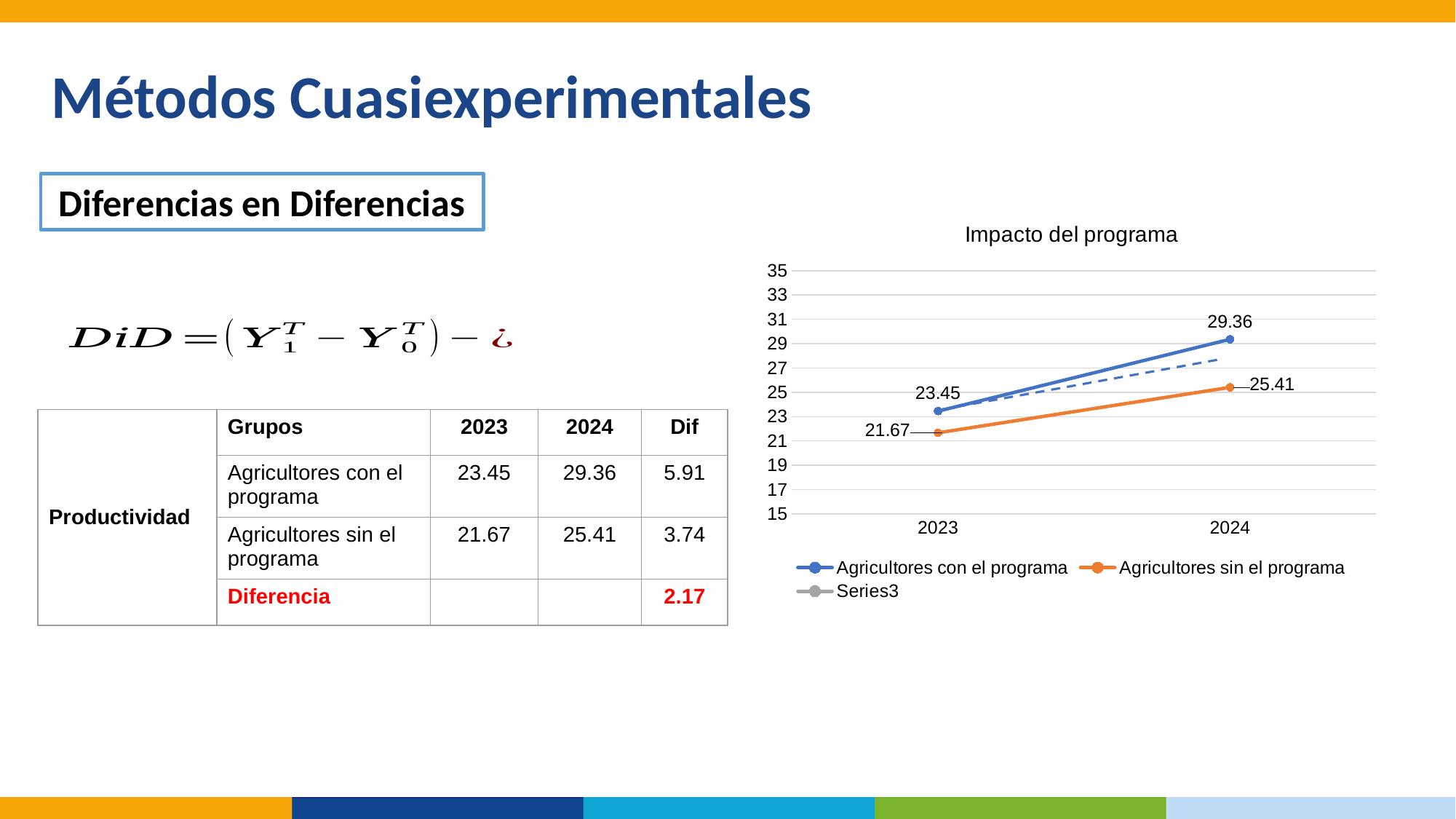
How many series does the chart legend list? 3 What is the value for Agricultores con el programa in 2024? 29.36 What is the value for Agricultores sin el programa in 2024? 25.41 What type of chart is shown on the slide? line chart Does the value for Agricultores sin el programa rise or fall from 2023 to 2024? rise What is the value for Agricultores con el programa in 2023? 23.45 What is the difference between the 2024 and 2023 values for Agricultores con el programa? 5.91 What is the value for Agricultores sin el programa in 2023? 21.67 How many years are shown on the x axis of the chart? 2 Which series has the higher value in 2024, Agricultores con el programa or Agricultores sin el programa? Agricultores con el programa What is the chart's title? Impacto del programa What is the difference between the 2024 and 2023 values for Agricultores sin el programa? 3.74